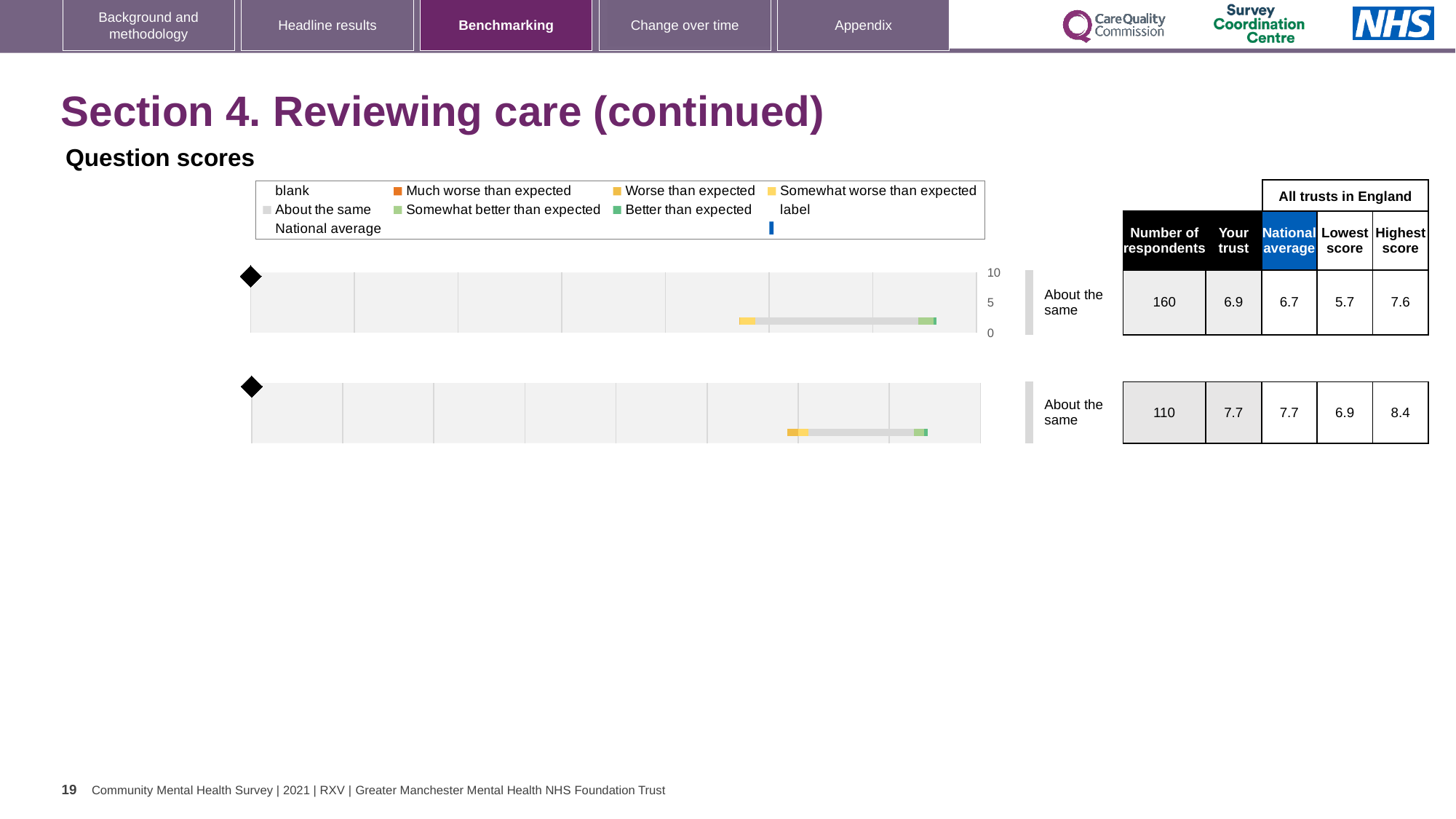
For the second (bottom) question row, what is the difference between the highest score and the lowest score? 1.5 For the first (top) question row, how many respondents are listed? 160 For the second (bottom) question row, how many respondents are listed? 110 For the first (top) question row, what is the national average score? 6.7 For the first (top) question row, what is the 'Your trust' score? 6.9 In the chart legend, what colour is used for 'Much worse than expected'? orange How many question rows (bars) are shown in the benchmarking chart area? 2 What benchmark category is given for both question rows? About the same What kind of chart is used to show the question scores on this slide? bar chart For the first (top) question row, which is larger: the 'Your trust' score or the national average? Your trust For the second (bottom) question row, what is the highest score among all trusts in England? 8.4